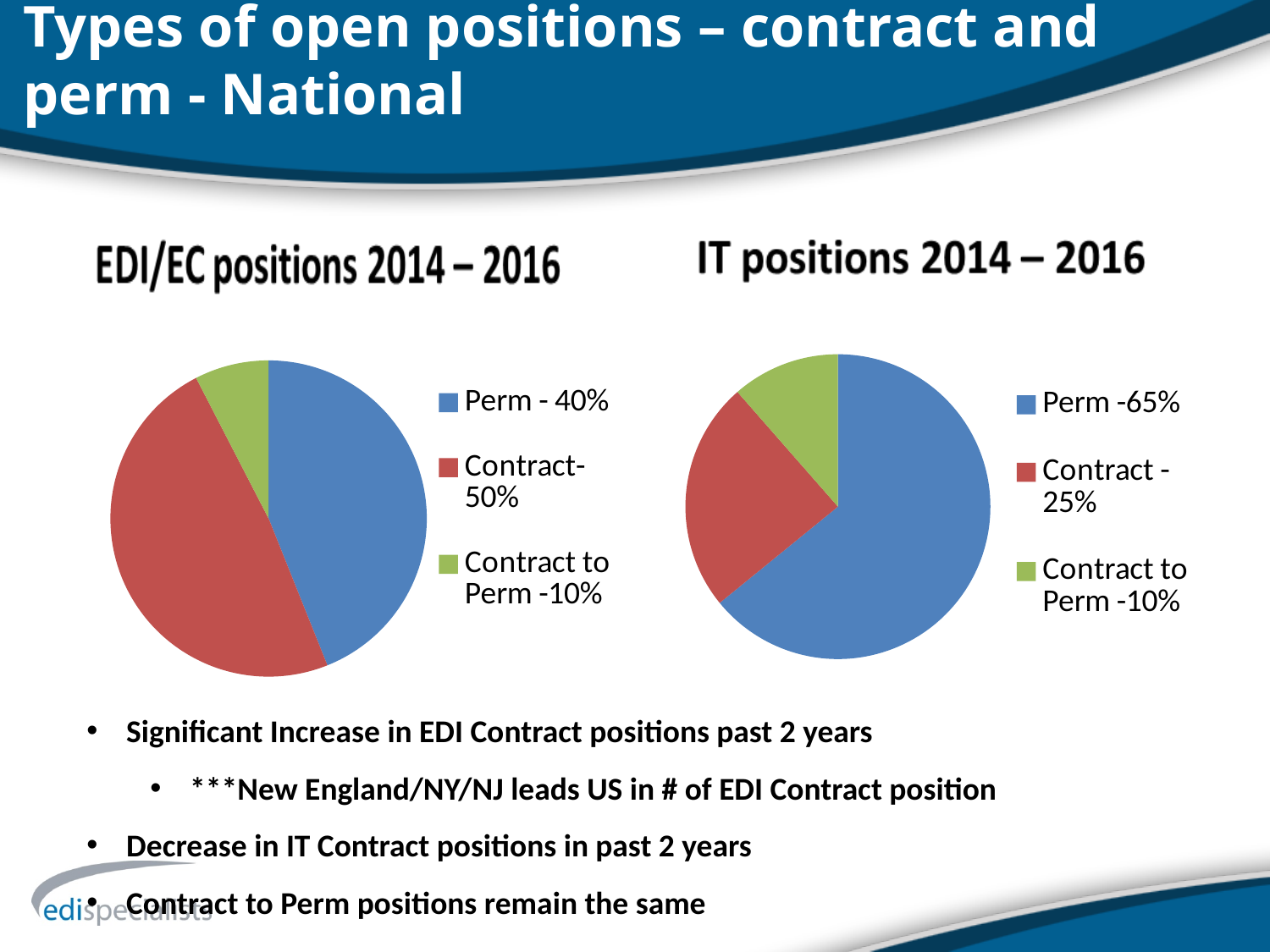
In the 'EDI/EC positions 2014 – 2016' pie chart, what is the difference between the Contract share and the Perm share? 10% In the 'EDI/EC positions 2014 – 2016' pie chart, what share do Perm positions have? 40% How many categories does the legend of the 'IT positions 2014 – 2016' chart list? 3 In the 'IT positions 2014 – 2016' pie chart, what share do Contract positions have? 25% In the 'IT positions 2014 – 2016' pie chart, what is the difference between the Perm share and the Contract share? 40% Which chart has the larger Perm share, 'EDI/EC positions 2014 – 2016' or 'IT positions 2014 – 2016'? IT positions 2014 – 2016 In the 'IT positions 2014 – 2016' pie chart, what share do Perm positions have? 65% In the 'EDI/EC positions 2014 – 2016' pie chart, which category has the largest slice? Contract In the 'IT positions 2014 – 2016' pie chart, which category has the smallest slice? Contract to Perm What type of chart is used for 'EDI/EC positions 2014 – 2016'? Pie chart